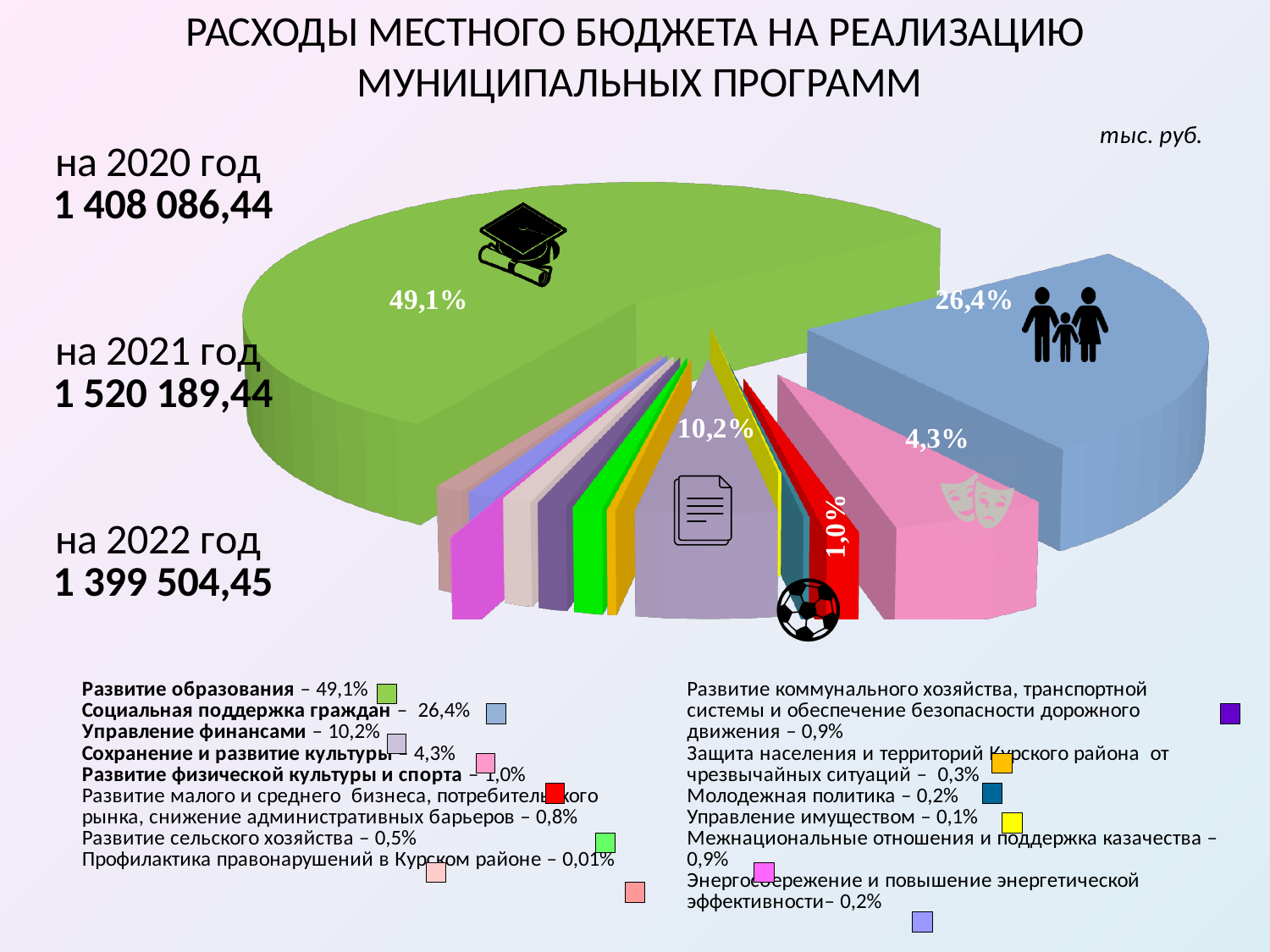
What is the value shown for Управление финансами? 10,2% What share of the pie does Развитие образования take? 49,1% What kind of chart is shown on the slide? pie chart What unit is indicated for the budget figures on the slide? тыс. руб. Which is larger: the share for Управление финансами or the share for Сохранение и развитие культуры? Управление финансами How many categories are listed in the legend of the pie chart? 14 What is the value shown for Развитие физической культуры и спорта? 1,0% What is the value shown for Сохранение и развитие культуры? 4,3% What is the value shown for Социальная поддержка граждан? 26,4% Which category has the largest share of the pie? Развитие образования What is the difference between the shares of Развитие образования and Социальная поддержка граждан? 22,7% Which category has the smallest share according to the legend? Профилактика правонарушений в Курском районе